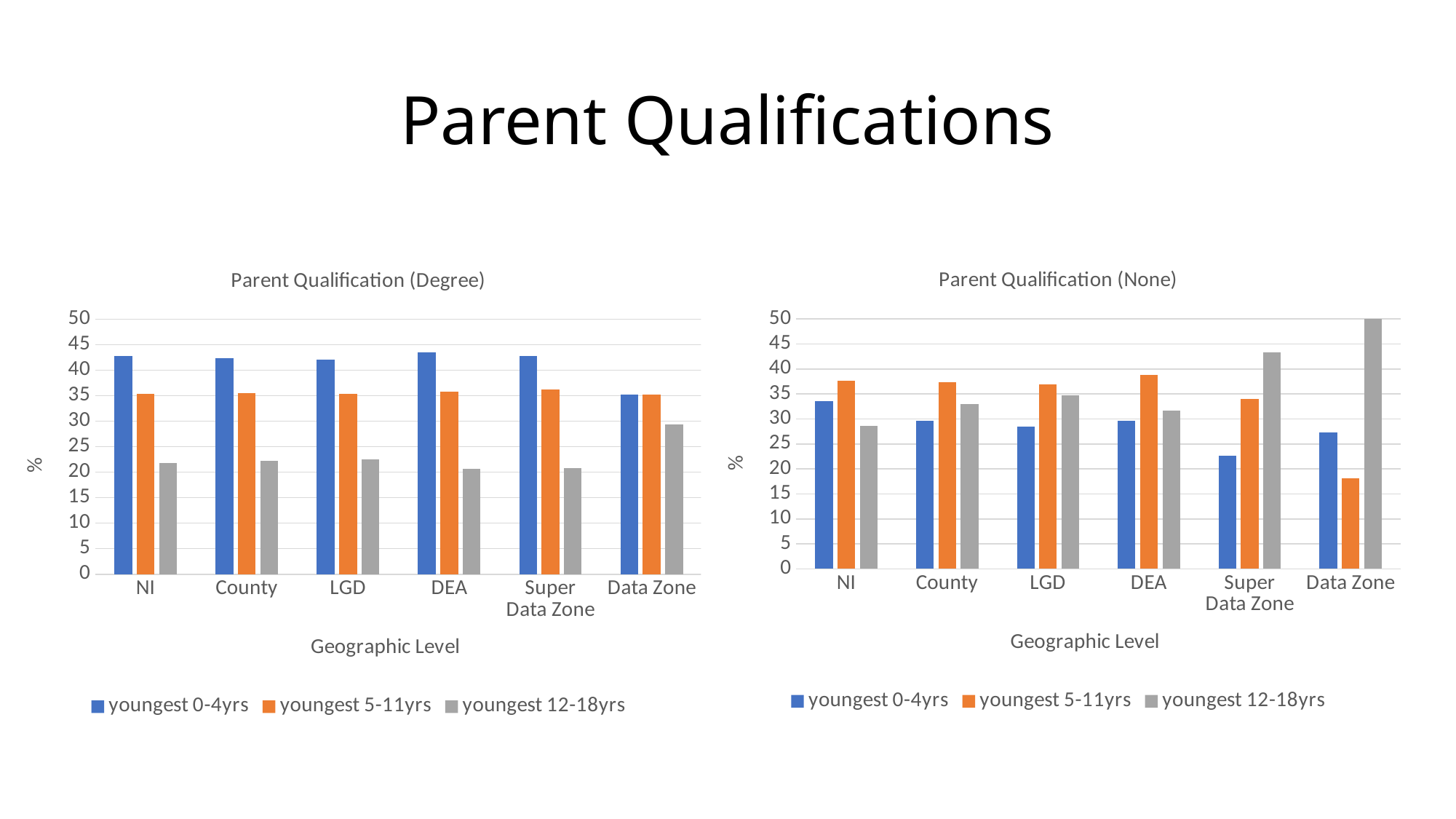
In the Parent Qualification (None) chart, which geographic level has the lowest value for youngest 5-11yrs? Data Zone In the Parent Qualification (Degree) chart, which geographic level has the lowest value for youngest 0-4yrs? Data Zone In the Parent Qualification (None) chart, is the value for youngest 0-4yrs at Super Data Zone greater or less than 25? less In the Parent Qualification (Degree) chart, is the value for youngest 12-18yrs at NI greater or less than 25? less What kind of chart is the Parent Qualification (Degree) chart on the left? bar chart How many series does the legend of the Parent Qualification (None) chart list? 3 In the Parent Qualification (Degree) chart, is the value for youngest 0-4yrs at NI greater or less than 40? greater In the Parent Qualification (None) chart, which geographic level has the highest value for youngest 12-18yrs? Data Zone In the Parent Qualification (None) chart, at Data Zone, which is larger: youngest 12-18yrs or youngest 5-11yrs? youngest 12-18yrs How many geographic level categories are shown on the x axis of the Parent Qualification (Degree) chart? 6 What is the label on the vertical axis of the Parent Qualification (Degree) chart? %